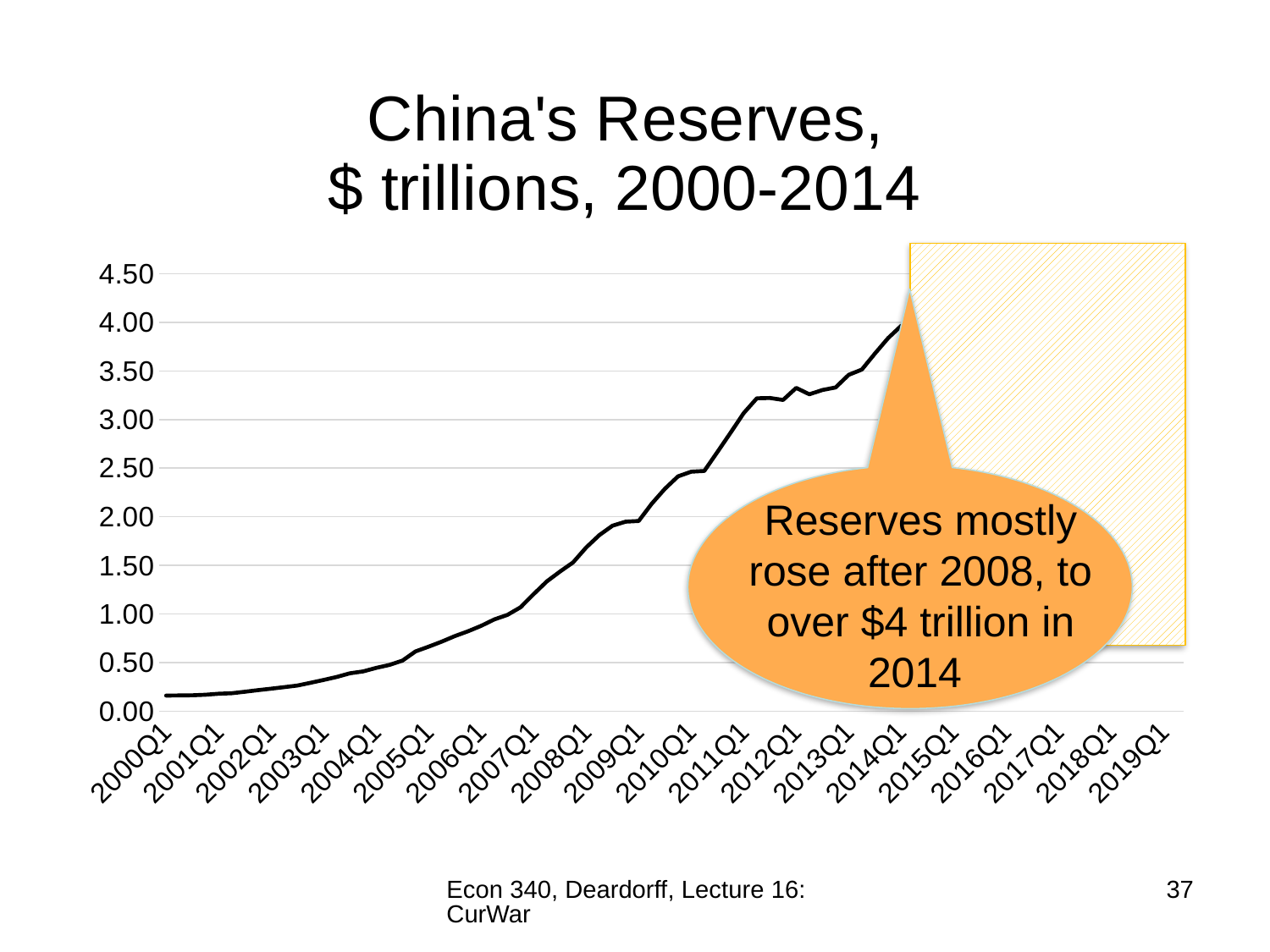
Is the value for 2006Q1 greater or less than 0.50? greater What does the callout on the chart say? Reserves mostly rose after 2008, to over $4 trillion in 2014 What kind of chart is shown on the slide? line chart Is the value for 2012Q1 greater or less than 3.00? greater What is the title of the chart? China's Reserves, $ trillions, 2000-2014 Is the value for 2010Q1 greater or less than 2.00? greater Do China's reserves generally rise or fall from 2000Q1 to 2014Q1? rise Which quarter on the x axis has the lowest value? 2000Q1 Which has the larger value, 2006Q1 or 2012Q1? 2012Q1